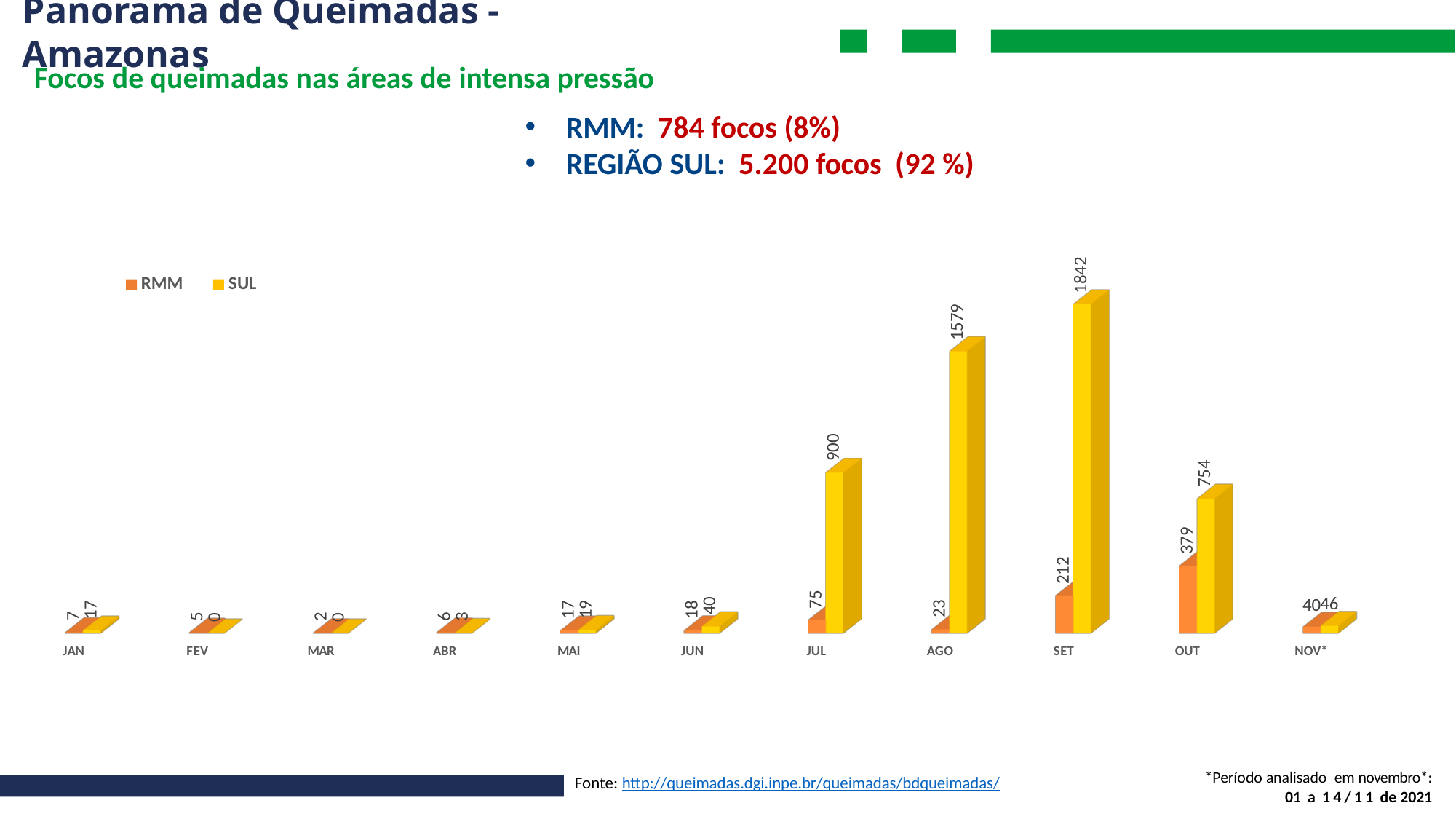
What is the SUL value for JUL? 900 Which is larger, the RMM value for SET or the RMM value for OUT? OUT Which series is shown in yellow? SUL What is the SUL value for SET? 1842 How many series does the legend list? 2 What kind of chart is shown? bar chart What is the difference between the SUL values for SET and AGO? 263 How many months are shown on the x axis? 11 Which month has the highest SUL value? SET What is the RMM value for AGO? 23 Which month has the highest RMM value? OUT What is the RMM value for OUT? 379